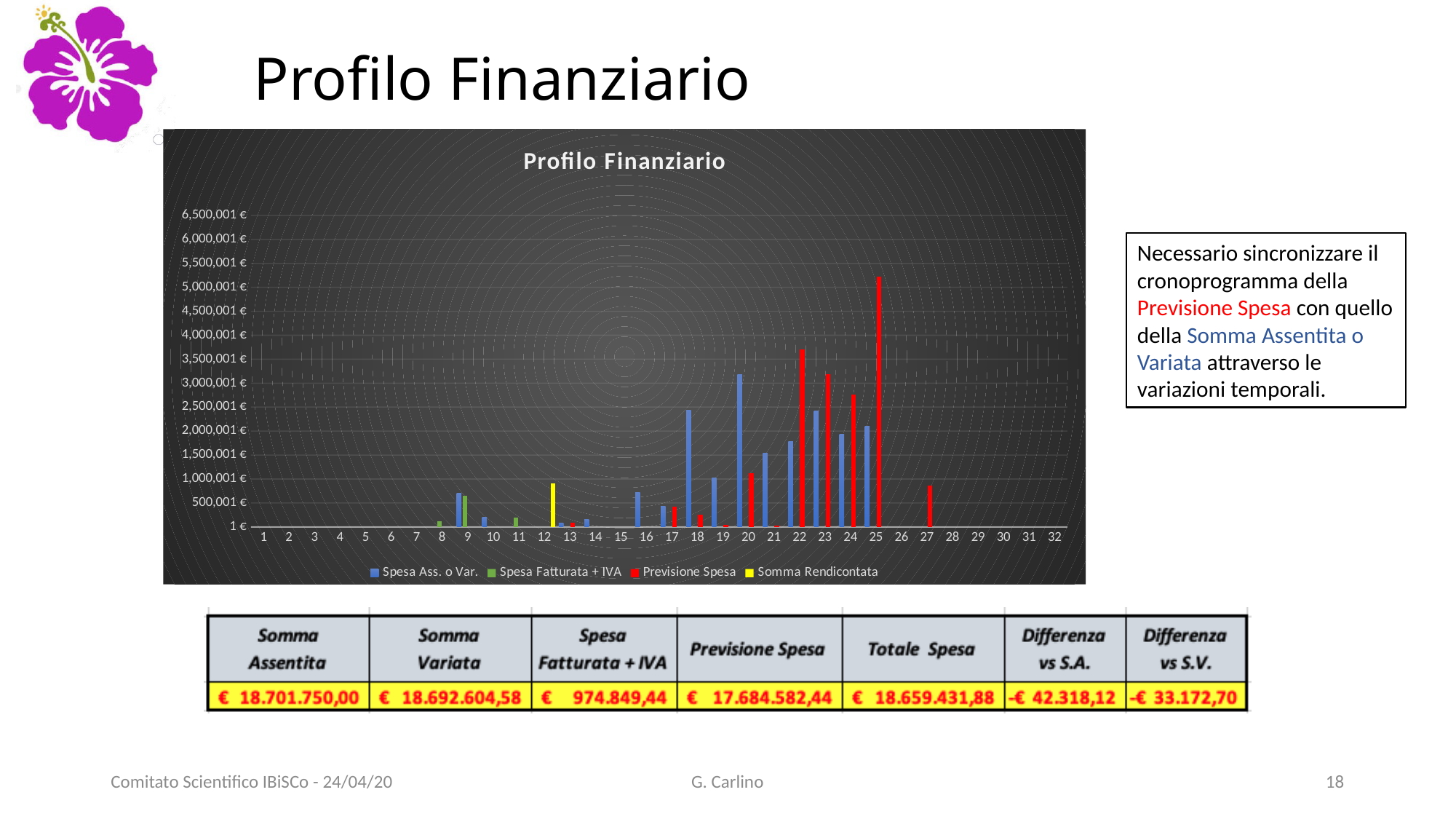
Is the Somma Rendicontata value at category 12 greater or less than 500,001 €? greater At which x-axis category is the Previsione Spesa bar highest? 25 Is the Previsione Spesa value at category 27 greater or less than 1,000,001 €? less At which x-axis category is the Spesa Ass. o Var. bar highest? 20 Which colour represents the Previsione Spesa series in the chart? red At category 23, which is larger: Previsione Spesa or Spesa Ass. o Var.? Previsione Spesa What is the title of the chart? Profilo Finanziario How many series does the chart legend list? 4 Is the Spesa Ass. o Var. value at category 20 greater or less than 2,500,001 €? greater What kind of chart is shown on the slide? bar chart How many categories are shown along the x axis of the chart? 32